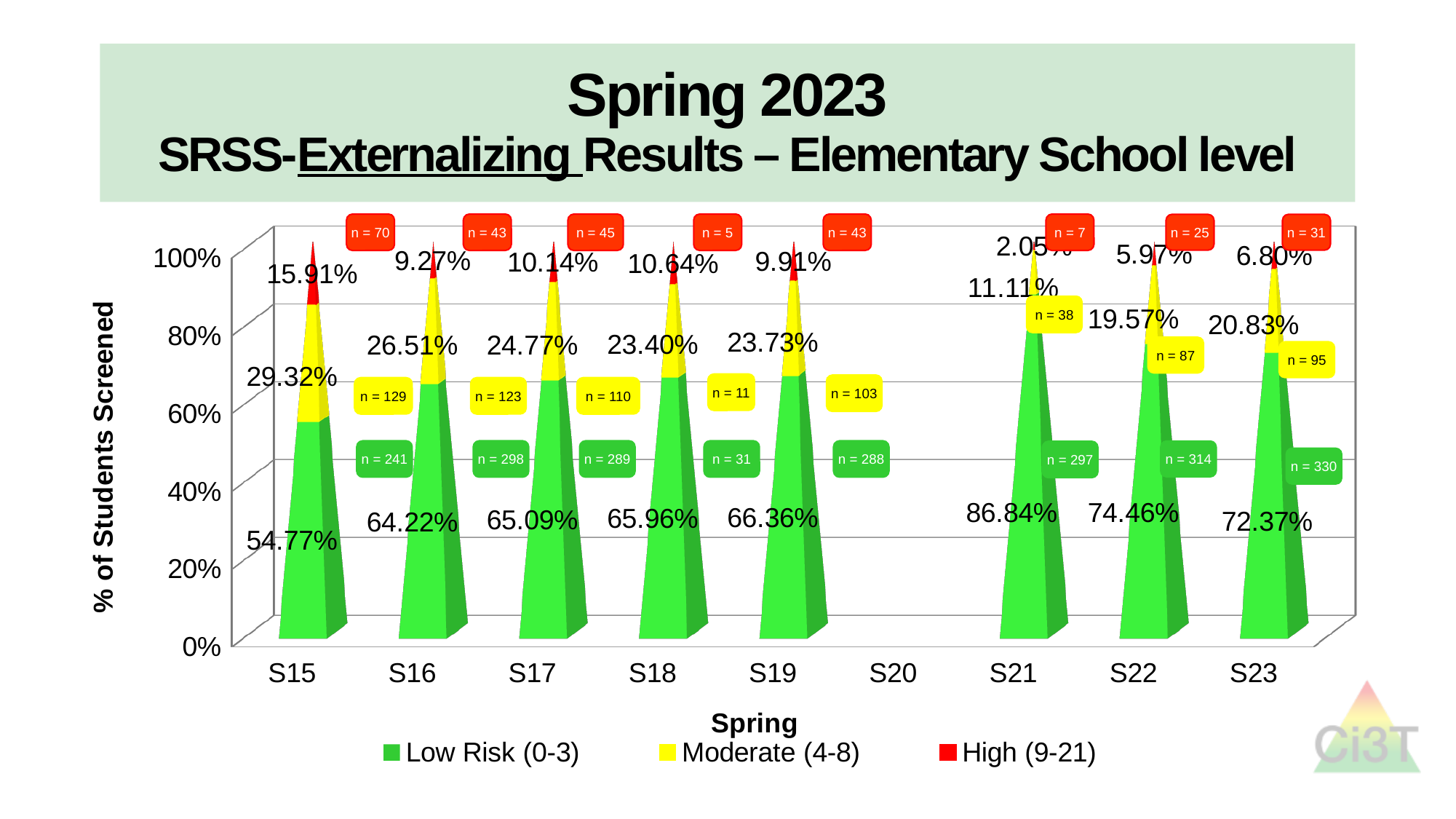
How many spring labels are shown on the x axis? 9 What is the label on the y axis of the chart? % of Students Screened What percentage of students screened were High (9-21) in S15? 15.91% Which spring has the lowest Low Risk (0-3) percentage? S15 What percentage of students screened were Low Risk (0-3) in S21? 86.84% What is the n value shown for the Low Risk (0-3) group in S23? n = 330 What percentage of students screened were Moderate (4-8) in S23? 20.83% What is the difference between the Low Risk (0-3) percentages for S22 and S23? 2.09% Which is larger, the High (9-21) percentage for S17 or for S18? S18 Which spring has the highest Low Risk (0-3) percentage? S21 How many series does the legend list? 3 What kind of chart is shown on the slide? Stacked bar chart